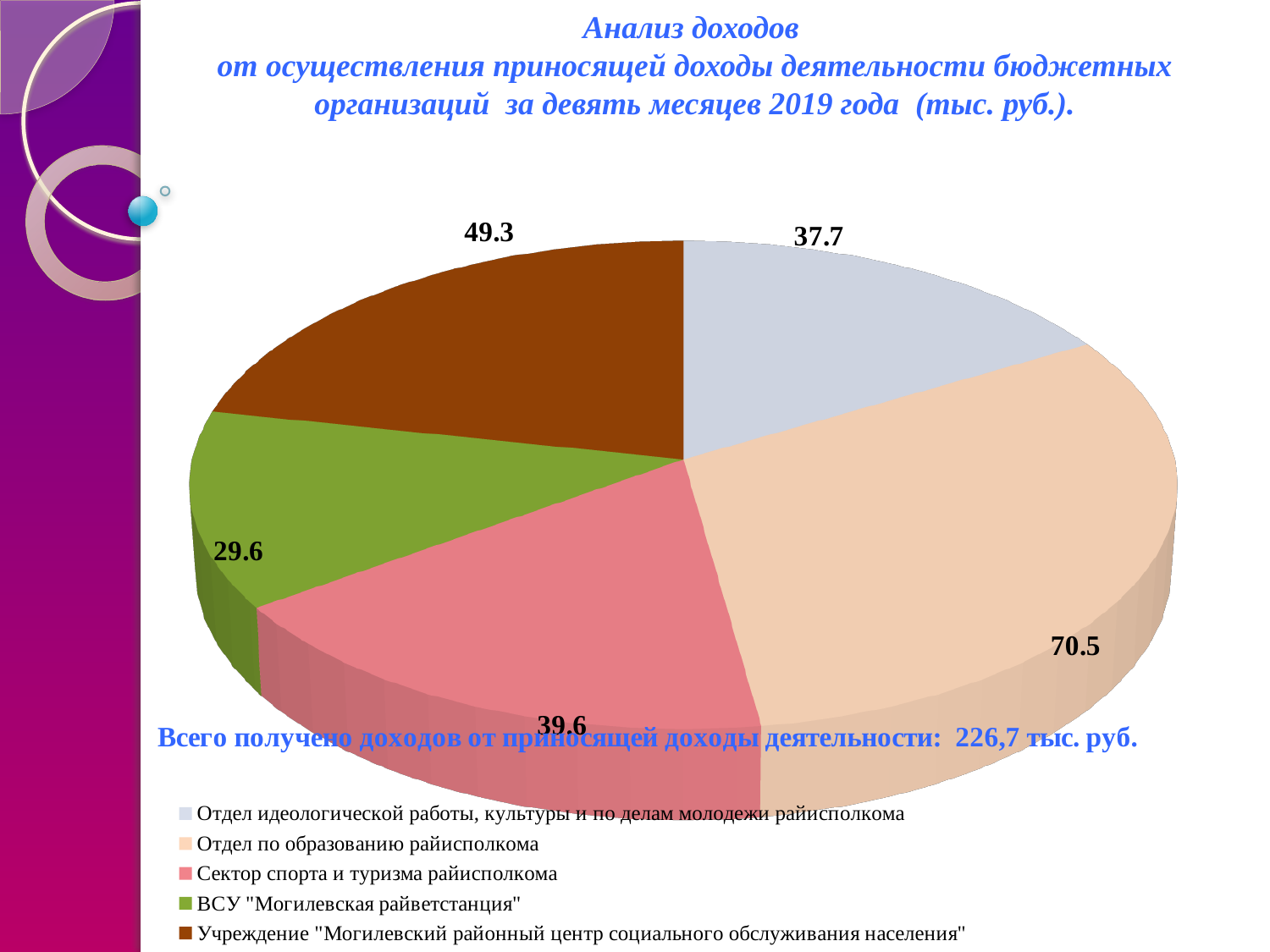
What is the difference between the values for Отдел по образованию райисполкома and ВСУ "Могилевская райветстанция"? 40.9 What is the value for Сектор спорта и туризма райисполкома? 39.6 Which category has the largest slice of the pie? Отдел по образованию райисполкома What is the value for Учреждение "Могилевский районный центр социального обслуживания населения"? 49.3 What kind of chart is shown on the slide? pie chart Which category has the smallest slice of the pie? ВСУ "Могилевская райветстанция" Which is larger: the value for Учреждение "Могилевский районный центр социального обслуживания населения" or the value for Отдел идеологической работы, культуры и по делам молодежи райисполкома? Учреждение "Могилевский районный центр социального обслуживания населения" How many slices does the pie chart have? 5 What is the value for Отдел по образованию райисполкома? 70.5 What is the value for ВСУ "Могилевская райветстанция"? 29.6 What is the total of all the slices in the pie chart? 226.7 What colour is the slice for Сектор спорта и туризма райисполкома? pink